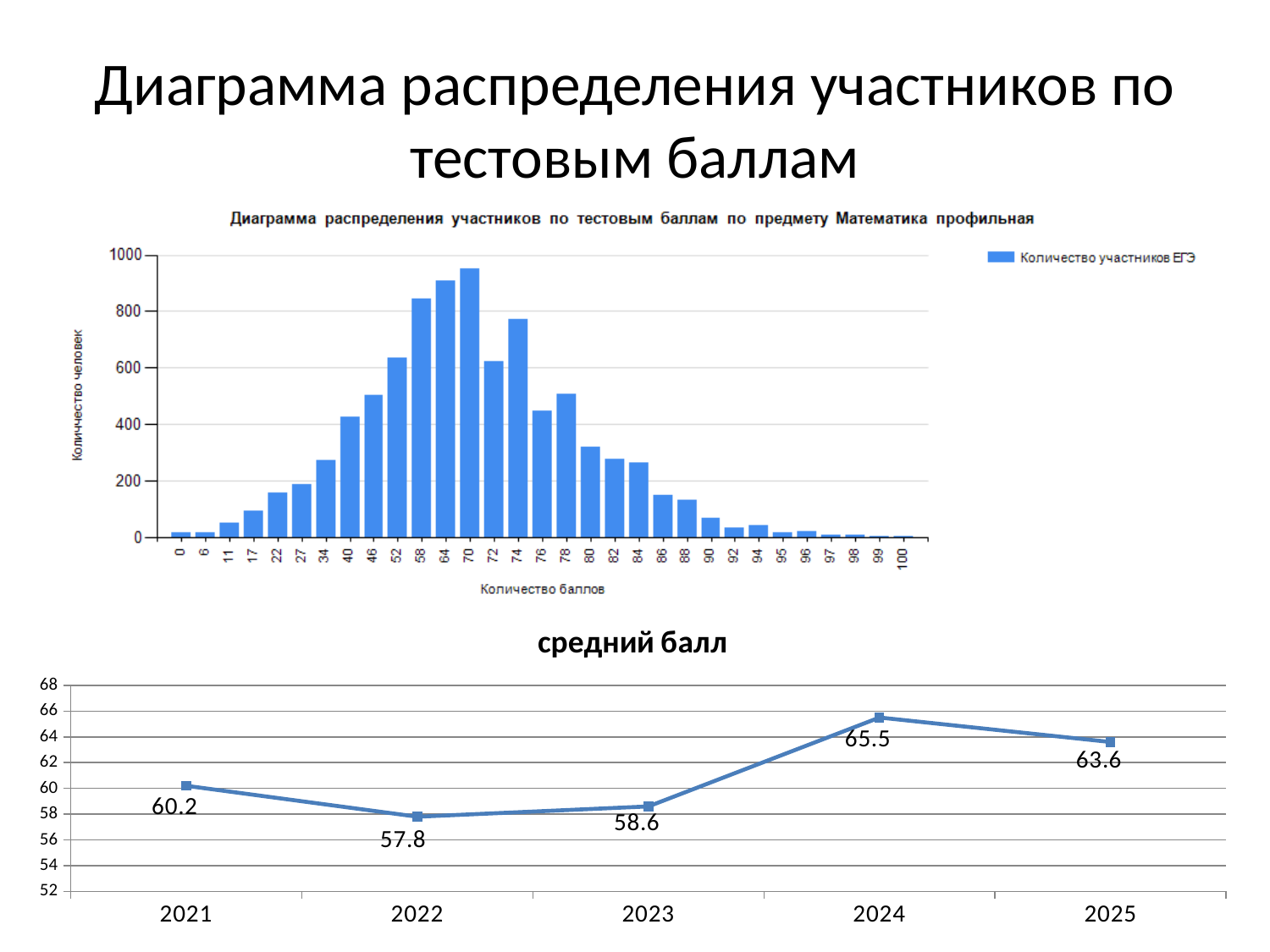
What kind of chart is the bottom chart titled 'средний балл'? line chart In the bottom chart titled 'средний балл', which year has the highest value? 2024 In the bottom chart titled 'средний балл', how many years are plotted? 5 In the bottom chart titled 'средний балл', what is the value for 2024? 65.5 In the bottom chart titled 'средний балл', which is larger, the value for 2021 or the value for 2023? 2021 In the bottom chart titled 'средний балл', what is the value for 2022? 57.8 In the bottom chart titled 'средний балл', do the values rise or fall from 2024 to 2025? fall In the top chart (distribution of participants by test score), is the value for score 58 greater or less than 800? greater In the top chart (distribution of participants by test score), which score has the highest number of participants? 70 In the bottom chart titled 'средний балл', which year has the lowest value? 2022 What kind of chart is the top chart (distribution of participants by test score)? bar chart In the bottom chart titled 'средний балл', what is the difference between the values for 2024 and 2022? 7.7